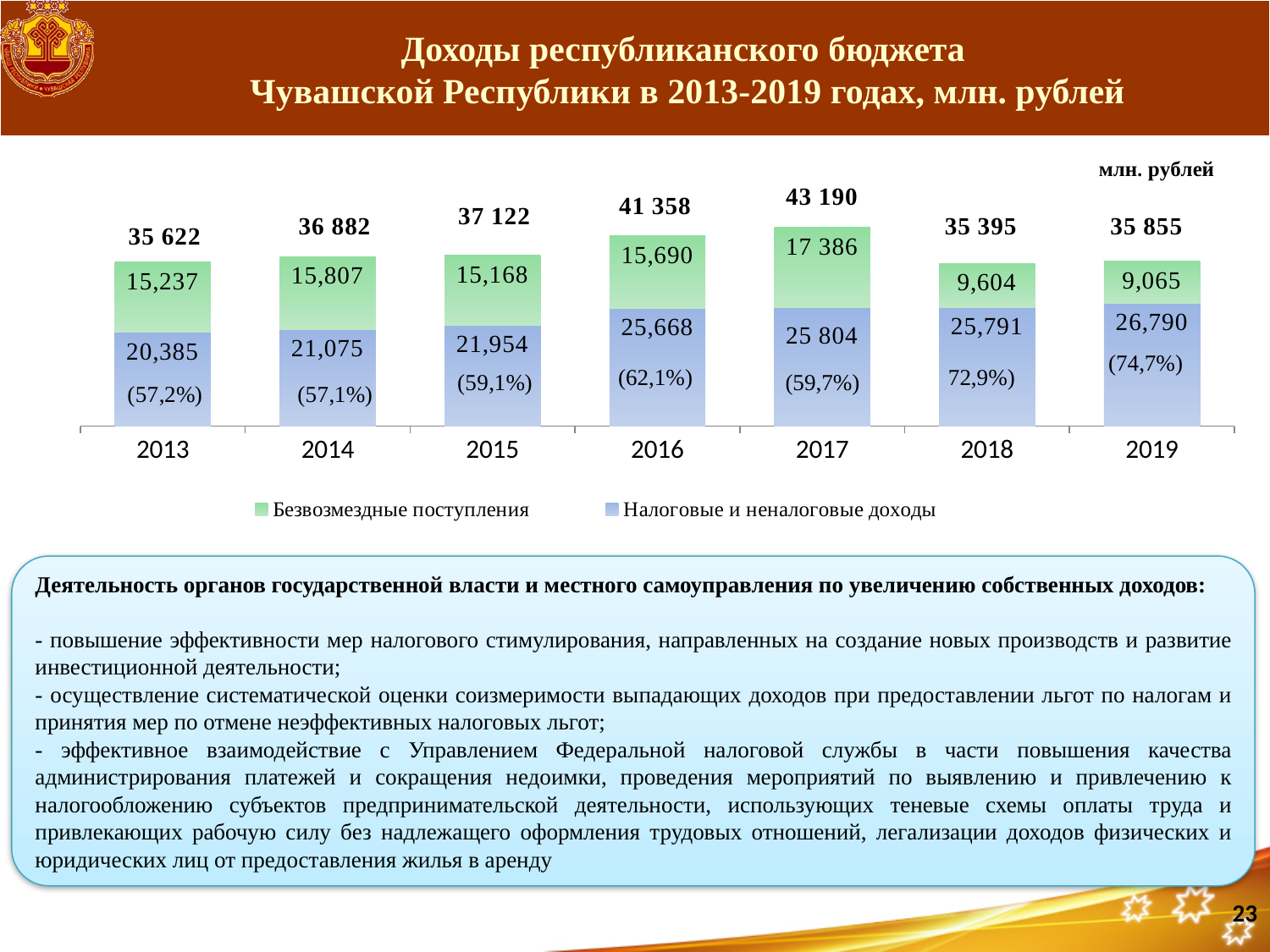
What share percentage is printed for Налоговые и неналоговые доходы in 2016? (62,1%) What is the total revenue shown above the bar for 2017? 43 190 What is the value of Безвозмездные поступления for 2014? 15,807 How many series does the legend list? 2 Which year has the lowest value of Безвозмездные поступления? 2019 Which is larger: Безвозмездные поступления in 2017 or in 2018? 2017 What is the difference between the total revenue in 2017 and in 2013? 7 568 How many years are shown on the x axis? 7 Which year has the highest total revenue? 2017 What kind of chart is shown on the slide? Stacked bar chart What is the value of Налоговые и неналоговые доходы for 2019? 26,790 Which colour represents Безвозмездные поступления in the chart? Green